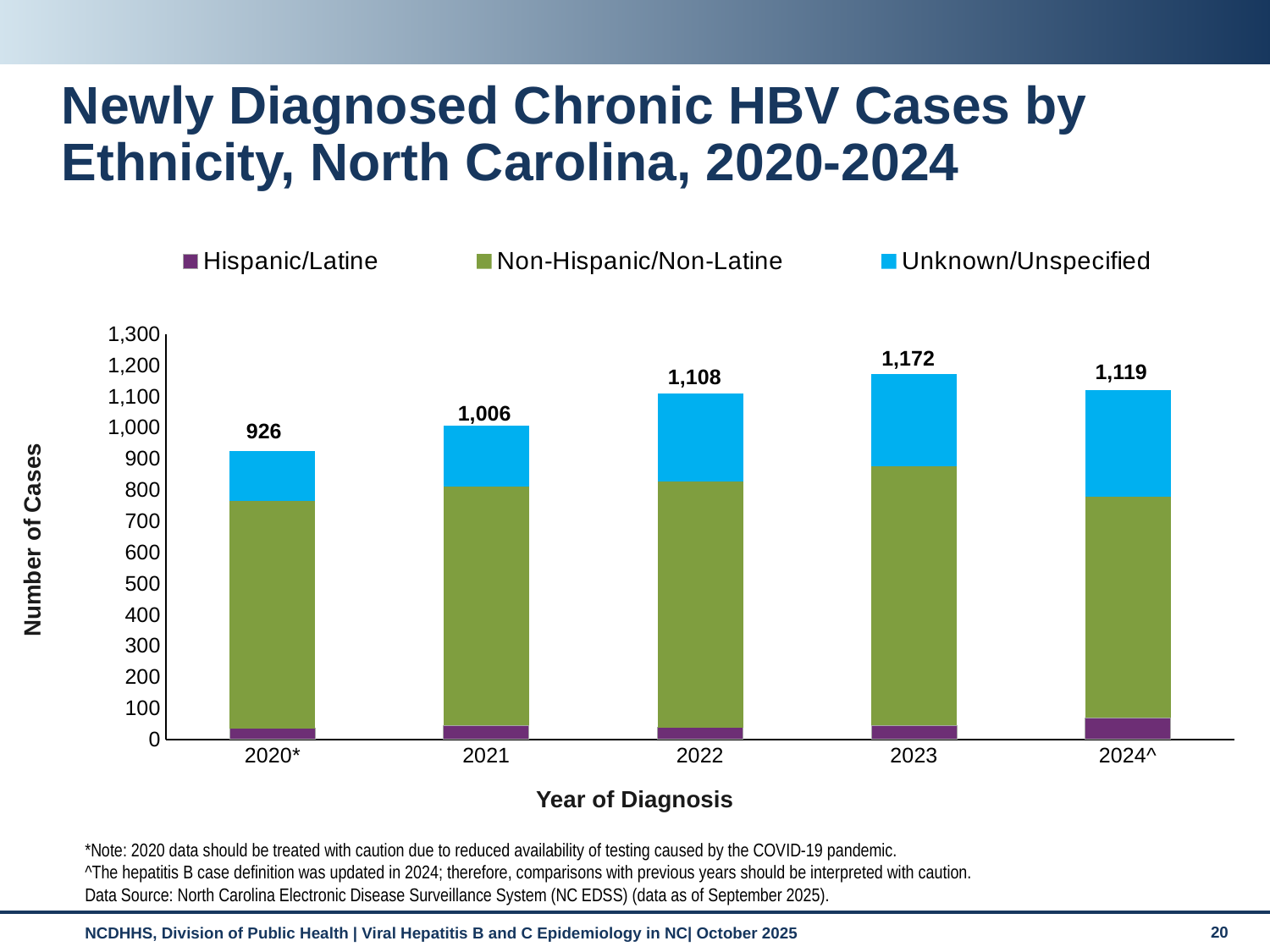
Which year has the highest total number of cases? 2023 What is the total number of newly diagnosed chronic HBV cases in 2023? 1,172 What kind of chart is shown on the slide? Stacked bar chart What is the total number of cases shown for 2020*? 926 Which year has a larger total, 2022 or 2024^? 2024^ What is the difference between the total cases in 2023 and 2024^? 53 What is the total number of cases shown for 2024^? 1,119 Which year has the lowest total number of cases? 2020* How many years are shown on the x axis? 5 Is the Hispanic/Latine segment for 2024^ greater or less than 100 cases? less What is the difference between the total cases in 2021 and 2020*? 80 How many series does the legend list? 3